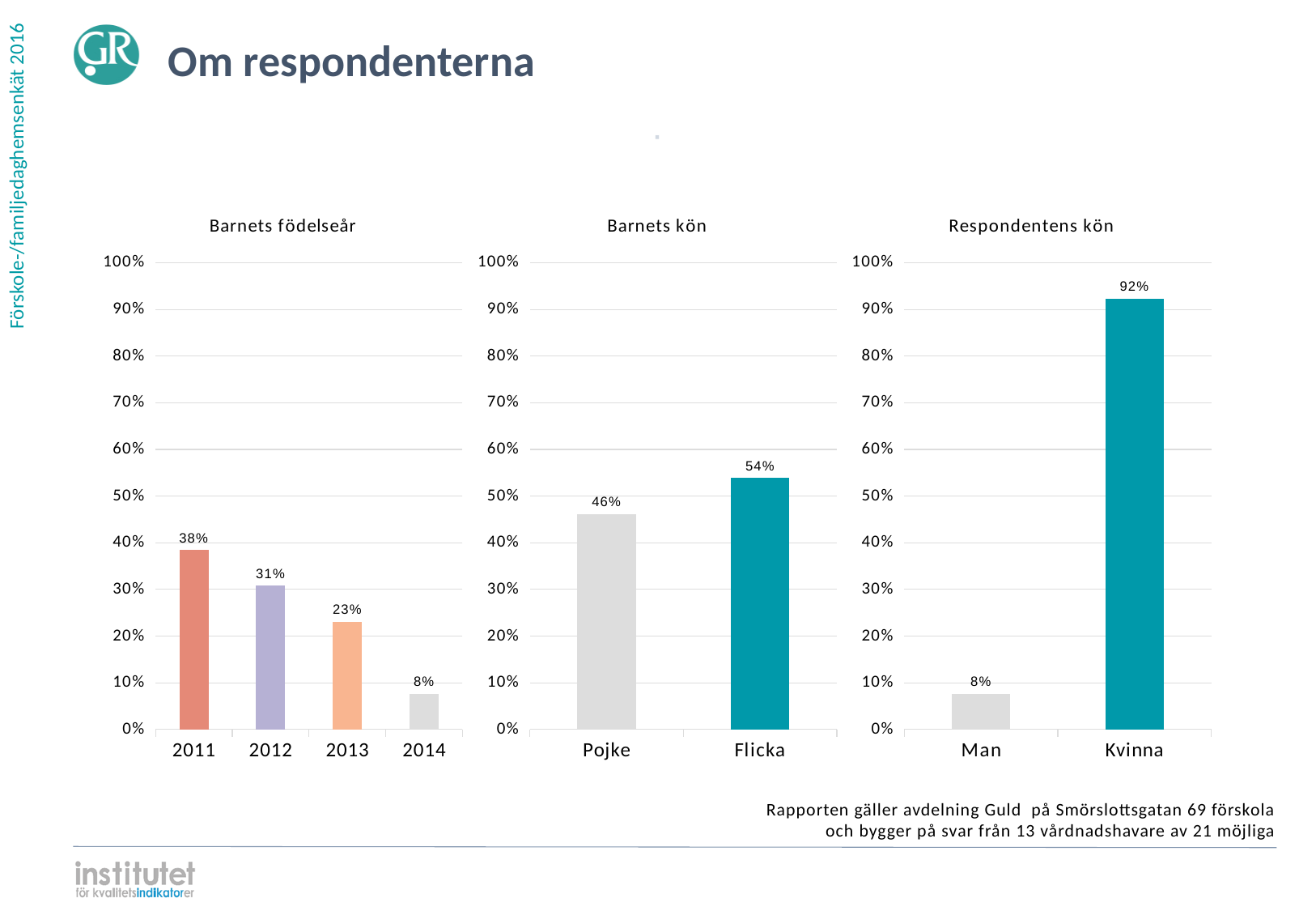
In the 'Respondentens kön' chart, is the value for Kvinna greater or less than 90%? greater In the 'Barnets födelseår' chart, what is the value for 2011? 38% In the 'Barnets födelseår' chart, how many birth years are shown? 4 In the 'Respondentens kön' chart, what is the value for Kvinna? 92% In the 'Barnets födelseår' chart, do the values rise or fall from 2011 to 2014? fall In the 'Barnets kön' chart, which category is higher, Pojke or Flicka? Flicka In the 'Barnets kön' chart, what is the difference between Flicka and Pojke? 8% In the 'Respondentens kön' chart, what is the value for Man? 8% In the 'Barnets kön' chart, what is the value for Pojke? 46% In the 'Barnets födelseår' chart, which birth year has the lowest value? 2014 In the 'Barnets födelseår' chart, what is the difference between the values for 2012 and 2013? 8% What kind of chart is the 'Barnets födelseår' chart? bar chart